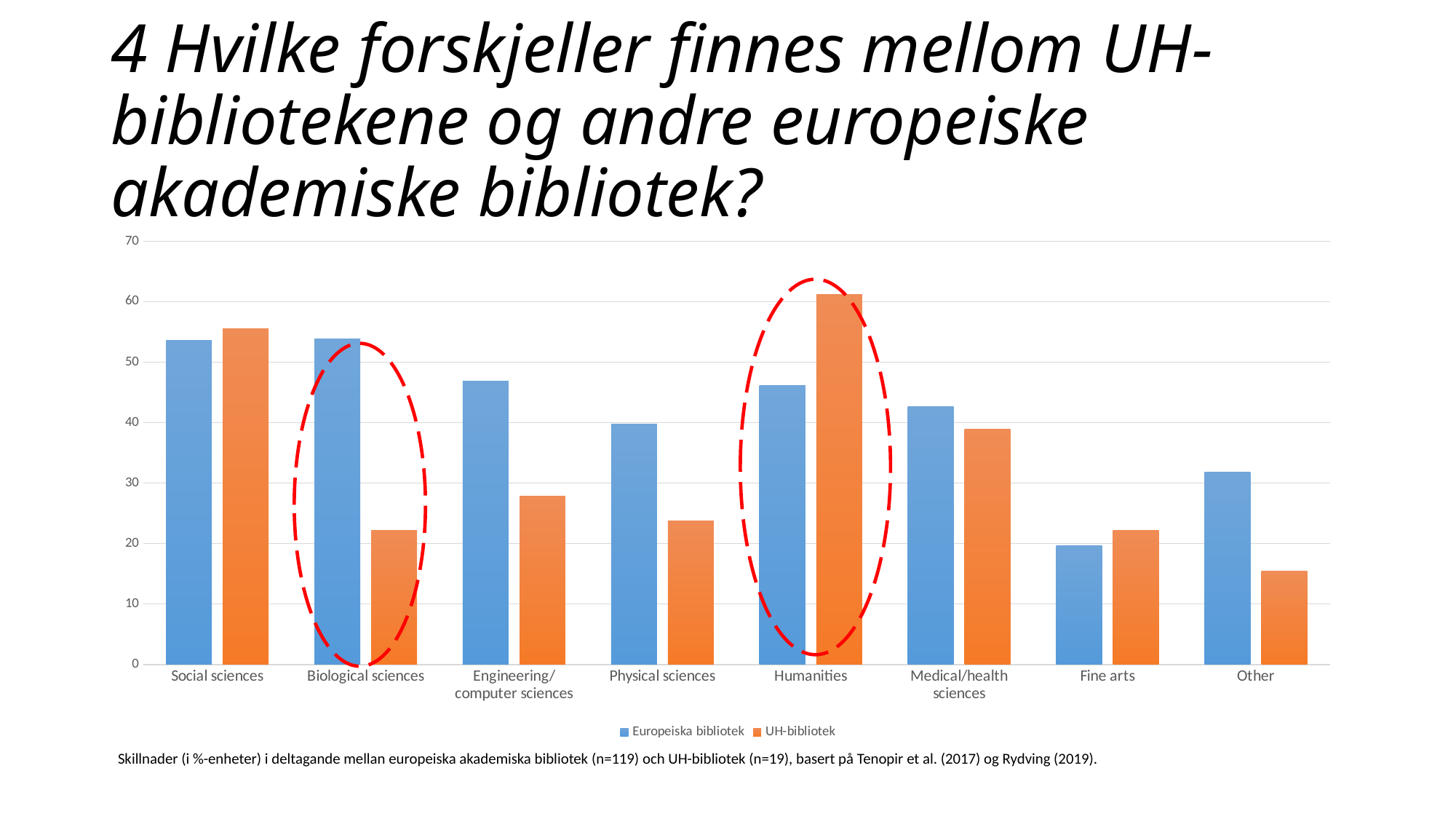
Is the value for UH-bibliotek in Humanities greater or less than 50? greater How many categories are shown on the x axis of the chart? 8 Which colour represents the UH-bibliotek series in the chart? orange Is the value for UH-bibliotek in Biological sciences greater or less than 30? less Is the value for Europeiska bibliotek in Engineering/computer sciences greater or less than 40? greater Which category has the lowest value for Europeiska bibliotek? Fine arts For Biological sciences, which series has the larger value, Europeiska bibliotek or UH-bibliotek? Europeiska bibliotek What kind of chart is shown on the slide? bar chart How many series does the chart's legend list? 2 Which category has the lowest value for UH-bibliotek? Other Which category has the highest value for UH-bibliotek? Humanities For Humanities, which series has the larger value, Europeiska bibliotek or UH-bibliotek? UH-bibliotek